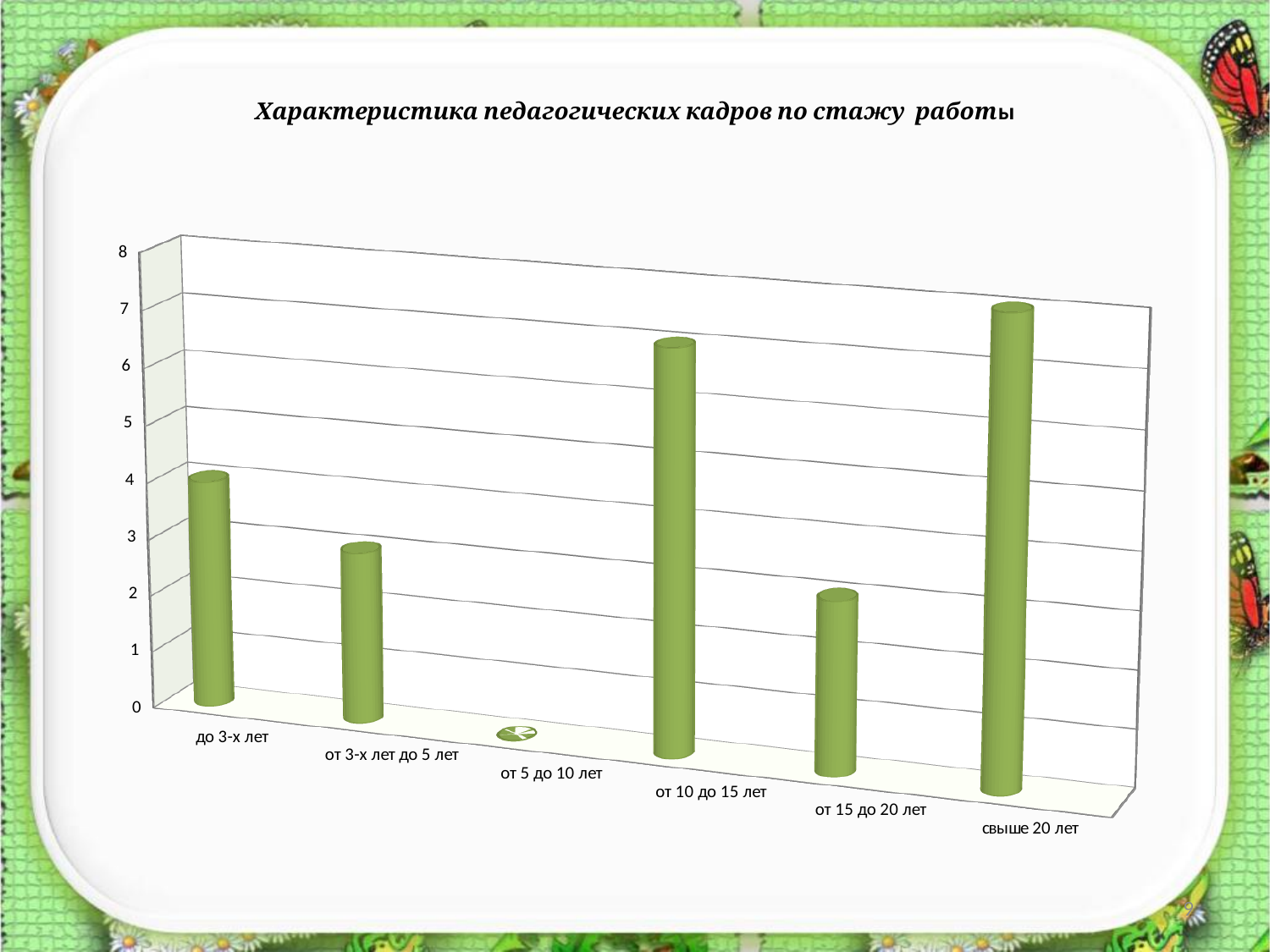
Is the value for до 3-х лет greater or less than 2? greater Is the value for от 10 до 15 лет greater or less than 5? greater Which is larger, the value for до 3-х лет or the value for от 15 до 20 лет? до 3-х лет Is the value for от 15 до 20 лет greater or less than 4? less Which category has the highest value? свыше 20 лет What kind of chart is shown on the slide? bar chart Which category has the lowest value? от 5 до 10 лет What is the value for от 5 до 10 лет? 0 What is the title of the chart? Характеристика педагогических кадров по стажу работы Which is larger, the value for от 10 до 15 лет or the value for от 3-х лет до 5 лет? от 10 до 15 лет How many categories of work experience are shown on the x axis? 6